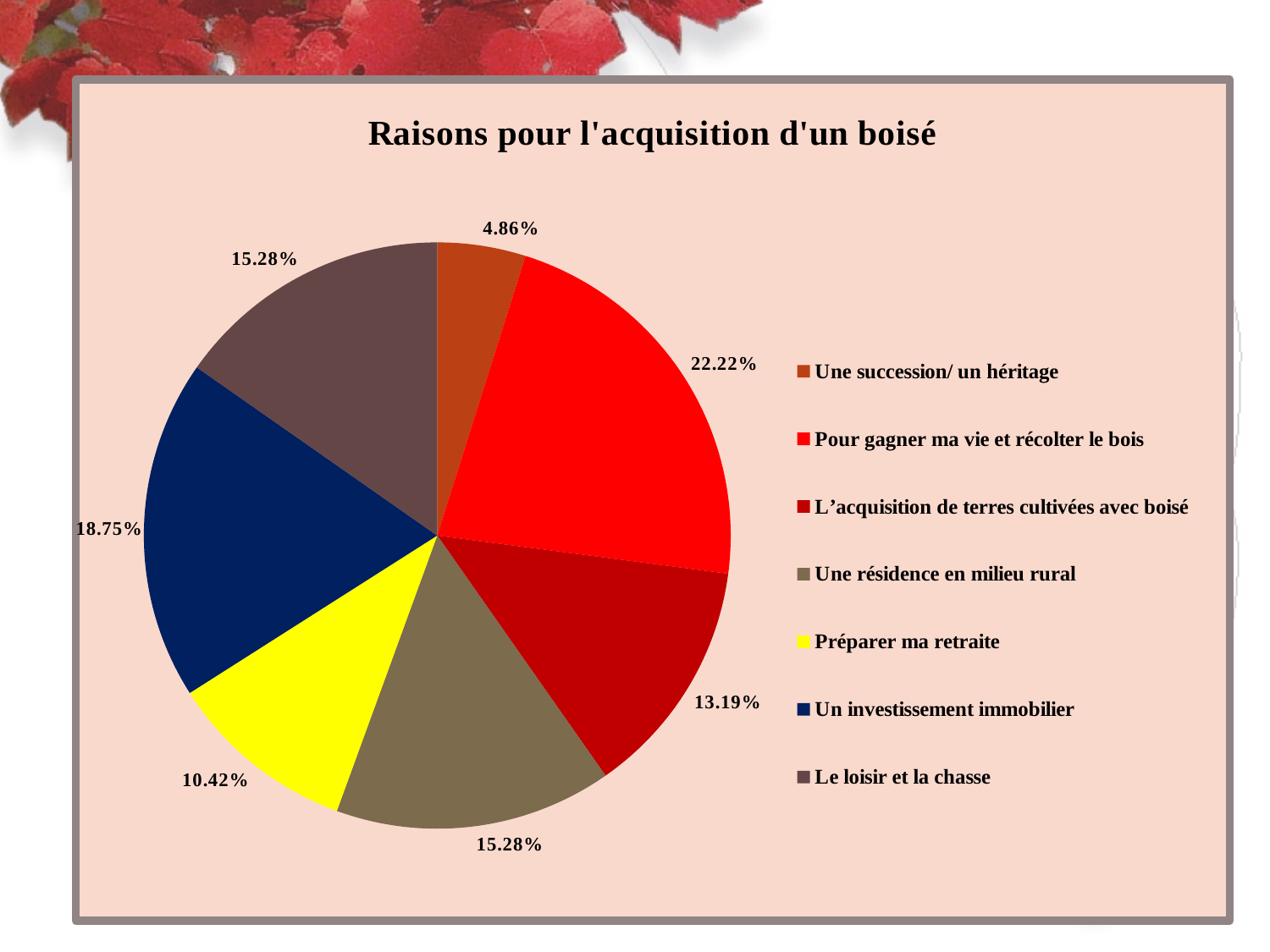
Which category has the smallest share of the pie? Une succession/ un héritage What share of the pie is 'Pour gagner ma vie et récolter le bois'? 22.22% What is the title of the chart? Raisons pour l'acquisition d'un boisé How many categories does the legend list? 7 What kind of chart is shown on the slide? Pie chart What share of the pie is 'Une succession/ un héritage'? 4.86% Which category has the largest share of the pie? Pour gagner ma vie et récolter le bois What share of the pie is 'Préparer ma retraite'? 10.42% Which is larger: the share for 'Préparer ma retraite' or the share for 'L’acquisition de terres cultivées avec boisé'? L’acquisition de terres cultivées avec boisé What is the difference between the shares of 'Pour gagner ma vie et récolter le bois' and 'Un investissement immobilier'? 3.47%